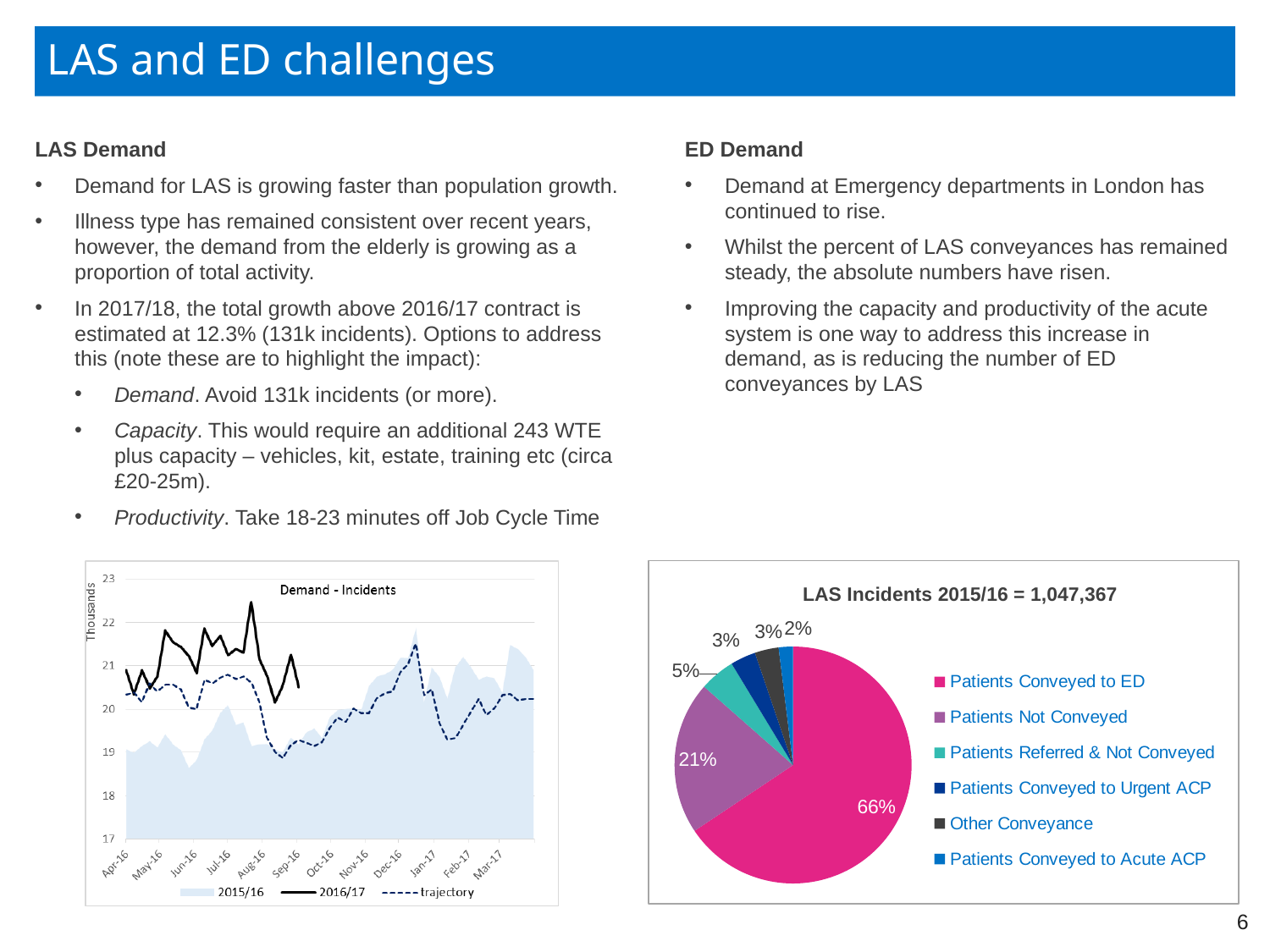
What kind of chart is the 'Demand - Incidents' chart on the bottom left? Line chart In the pie chart titled 'LAS Incidents 2015/16 = 1,047,367', how many percentage points larger is 'Patients Conveyed to ED' than 'Patients Not Conveyed'? 45 percentage points How many series does the legend of the 'Demand - Incidents' chart list? 3 How many categories does the pie chart titled 'LAS Incidents 2015/16 = 1,047,367' show? 6 In the pie chart titled 'LAS Incidents 2015/16 = 1,047,367', which category has the smallest share? Patients Conveyed to Acute ACP In the pie chart titled 'LAS Incidents 2015/16 = 1,047,367', which is larger: 'Patients Referred & Not Conveyed' or 'Patients Conveyed to Acute ACP'? Patients Referred & Not Conveyed What total number of LAS incidents for 2015/16 is stated in the pie chart's title? 1,047,367 In the pie chart titled 'LAS Incidents 2015/16 = 1,047,367', what share of incidents is 'Patients Referred & Not Conveyed'? 5% In the 'Demand - Incidents' chart, is the peak value of the 2016/17 series in Aug-16 greater or less than 22 thousand? greater In the pie chart titled 'LAS Incidents 2015/16 = 1,047,367', which category has the largest share? Patients Conveyed to ED In the pie chart titled 'LAS Incidents 2015/16 = 1,047,367', what share of incidents is 'Patients Conveyed to ED'? 66% In the pie chart titled 'LAS Incidents 2015/16 = 1,047,367', what share of incidents is 'Patients Not Conveyed'? 21%